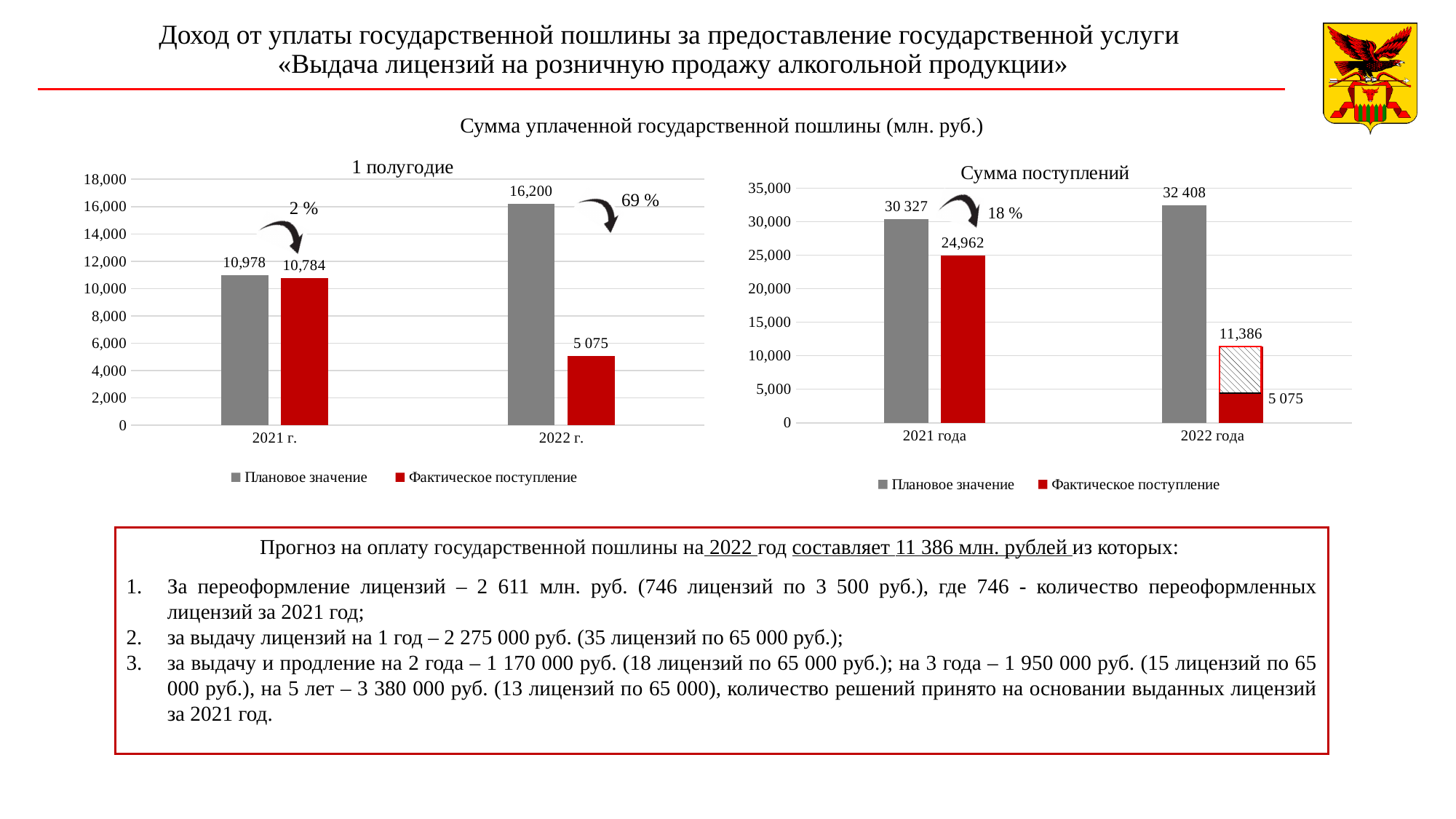
In the chart titled «Сумма поступлений», what is the value of «Плановое значение» for 2022 года? 32 408 In the chart titled «1 полугодие», what is the value of «Фактическое поступление» for 2022 г.? 5 075 In the chart titled «1 полугодие», what is the value of «Плановое значение» for 2021 г.? 10,978 In the chart titled «Сумма поступлений», what is the value of «Плановое значение» for 2021 года? 30 327 What kind of chart is the chart titled «Сумма поступлений»? bar chart In the chart titled «1 полугодие», which is larger for 2022 г.: «Плановое значение» or «Фактическое поступление»? Плановое значение In the chart titled «Сумма поступлений», what is the value of «Фактическое поступление» for 2021 года? 24,962 In the chart titled «1 полугодие», what is the difference between «Плановое значение» and «Фактическое поступление» for 2021 г.? 194 In the chart titled «Сумма поступлений», which category has the highest «Плановое значение»? 2022 года In the chart titled «1 полугодие», what is the value of «Плановое значение» for 2022 г.? 16,200 How many series does the legend of the chart titled «1 полугодие» list? 2